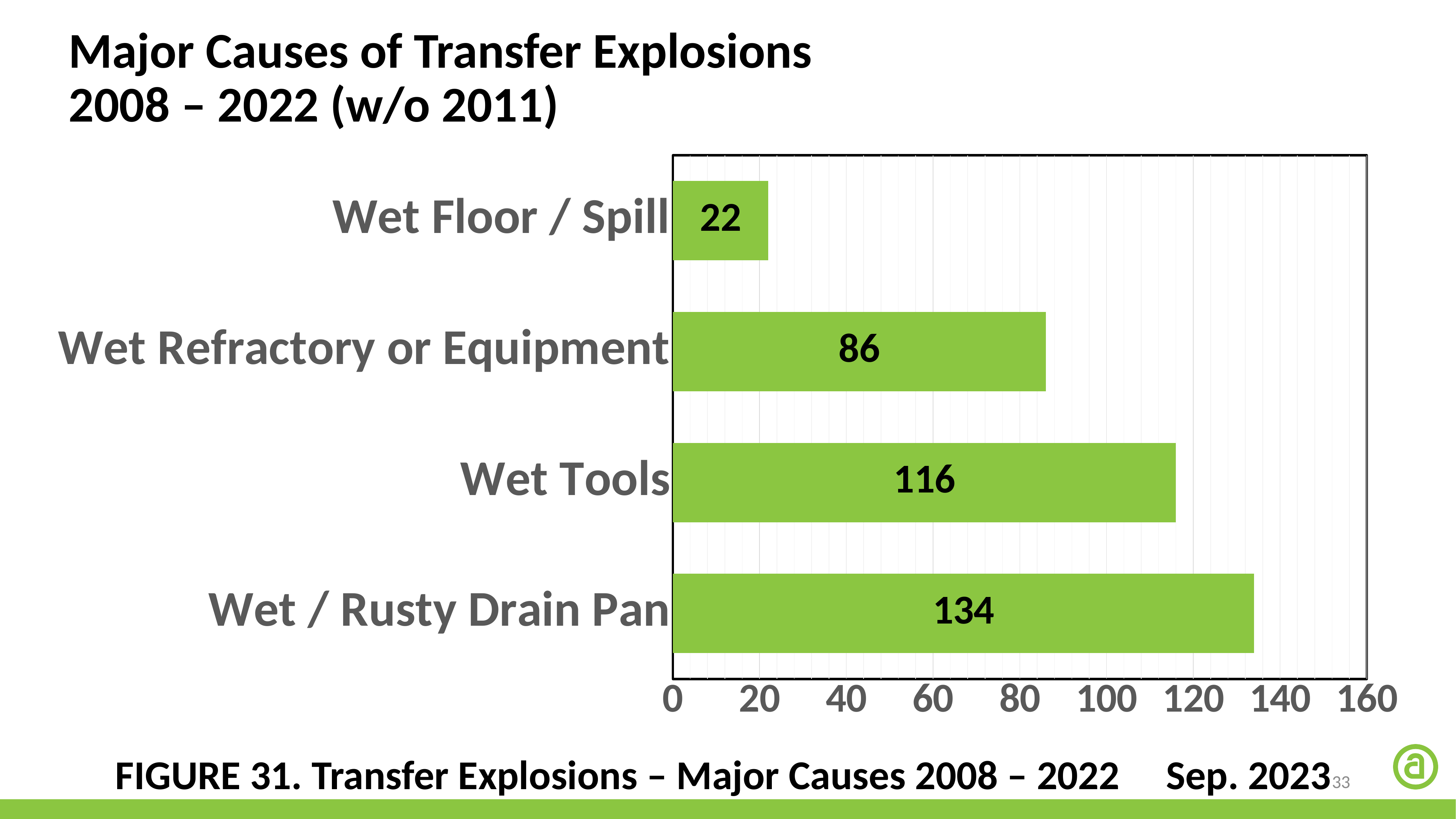
How many causes are shown in the chart? 4 What is the value for Wet Floor / Spill? 22 What is the value for Wet Tools? 116 What is the difference between the values for Wet / Rusty Drain Pan and Wet Tools? 18 What is the difference between the values for Wet Refractory or Equipment and Wet Floor / Spill? 64 Which is larger, the value for Wet Tools or the value for Wet Refractory or Equipment? Wet Tools Which cause has the highest value? Wet / Rusty Drain Pan What is the value for Wet / Rusty Drain Pan? 134 Which cause has the lowest value? Wet Floor / Spill What is the value for Wet Refractory or Equipment? 86 What kind of chart is shown on the slide? bar chart What is the title of the slide? Major Causes of Transfer Explosions 2008 – 2022 (w/o 2011)